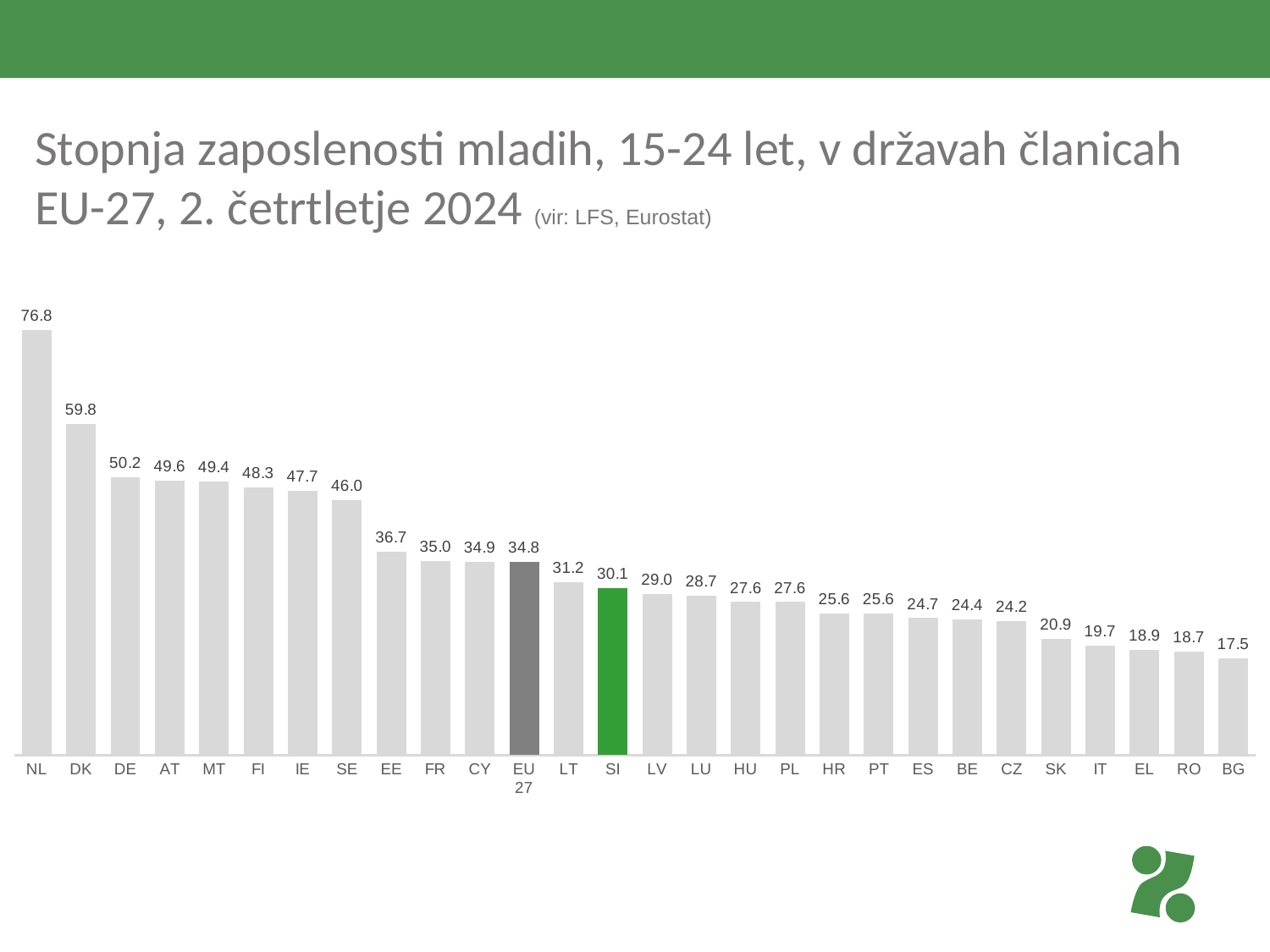
What is the youth employment rate shown for NL? 76.8 What is the difference between the values for NL and DK? 17.0 What value is shown for EU 27? 34.8 What value is shown for SI? 30.1 What kind of chart is shown on the slide? Bar chart What is the difference between the values for EU 27 and SI? 4.7 Which country has the highest value on the chart? NL Which has a higher value, DE or SE? DE How many bars are shown on the chart? 28 Do the values rise or fall from left to right along the x axis? Fall Which country has the lowest value on the chart? BG Which bar is coloured green on the chart? SI